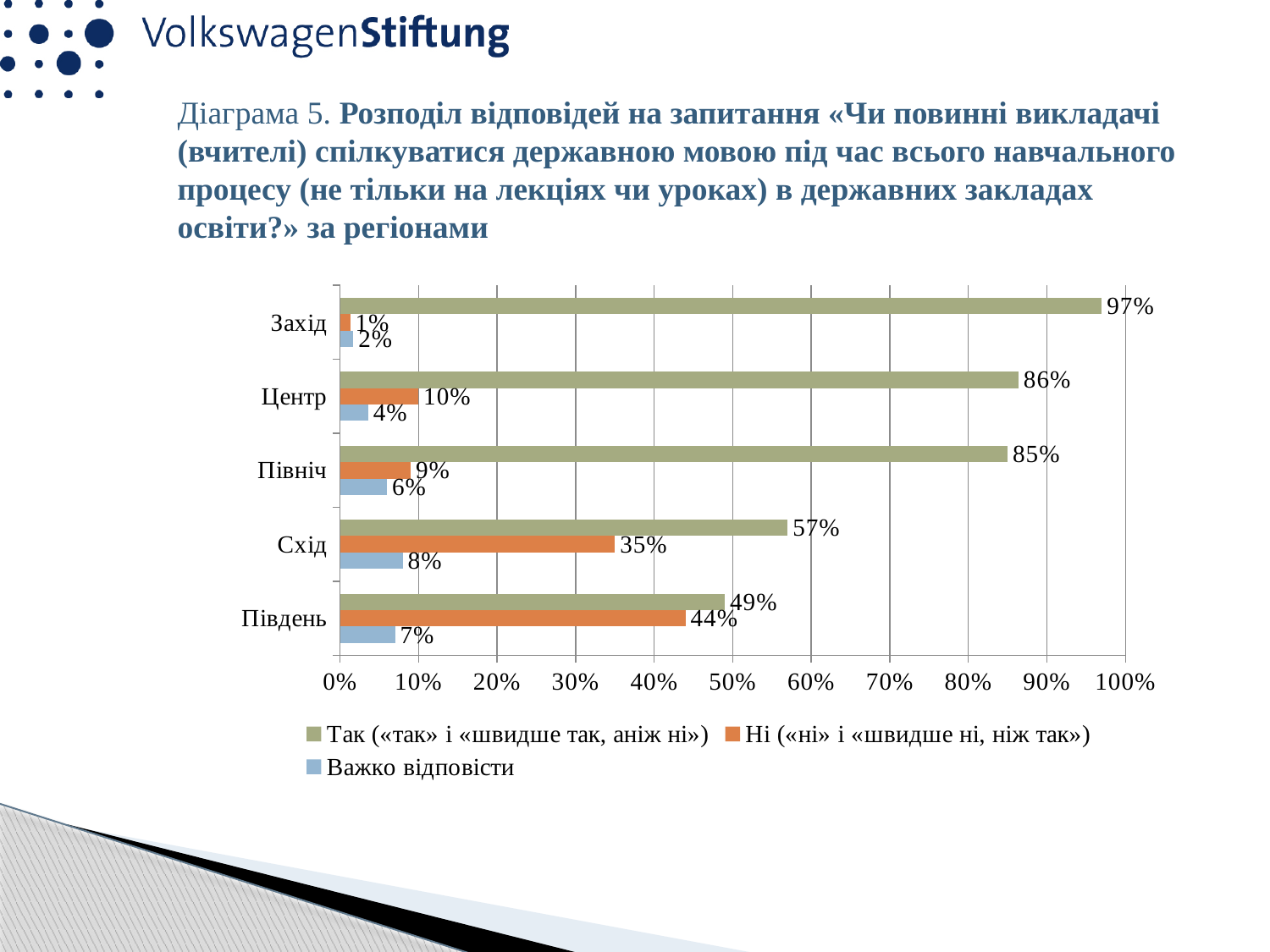
What kind of chart is shown on the slide? Bar chart What is the value of «Важко відповісти» for Схід? 8% What is the total of the three values for Північ? 100% How many series does the legend list? 3 What is the difference between the «Так» values for Центр and Схід? 29% Which region has the lowest value for «Ні»? Захід What is the value of «Ні» for Південь? 44% What is the value of «Так» for Захід? 97% Which is larger for Південь: «Так» or «Ні»? Так Which colour represents «Важко відповісти» in the legend? Blue Which region has the highest value for «Так»? Захід How many regions are shown on the chart? 5